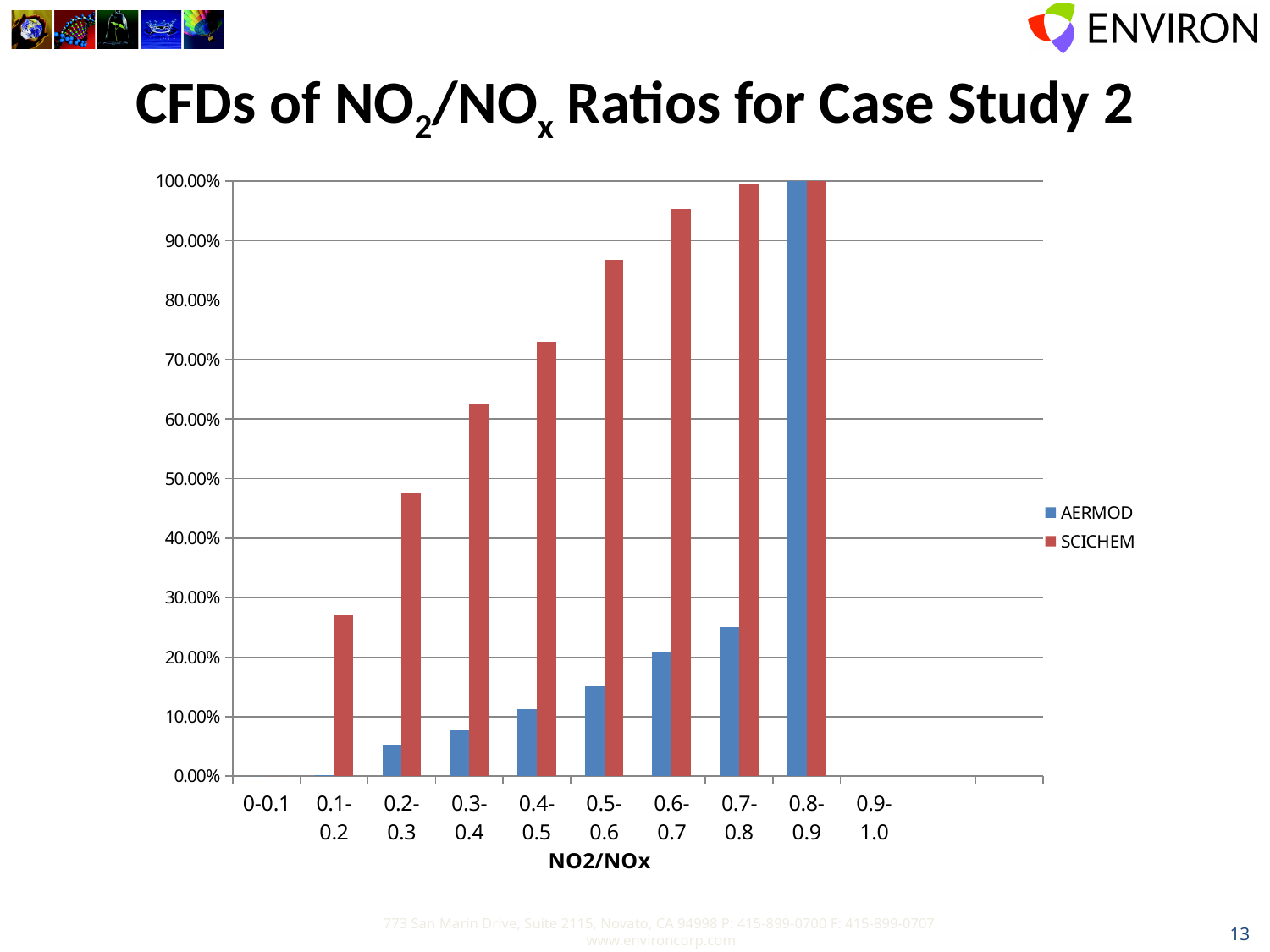
Is the AERMOD value for the 0.7-0.8 category greater or less than 30.00%? less Which series is shown in red? SCICHEM What is the title of the x axis? NO2/NOx Is the SCICHEM value for the 0.5-0.6 category greater or less than 80.00%? greater How many series does the legend list? 2 What kind of chart is shown on the slide? bar chart What is the AERMOD value for the 0.8-0.9 category? 100.00% Do the SCICHEM values rise or fall from the 0.1-0.2 category to the 0.8-0.9 category? rise Is the SCICHEM value for the 0.2-0.3 category greater or less than 40.00%? greater What is the SCICHEM value for the 0.8-0.9 category? 100.00% How many NO2/NOx ratio categories are shown on the x axis? 10 For the 0.4-0.5 category, which series has the larger value, AERMOD or SCICHEM? SCICHEM